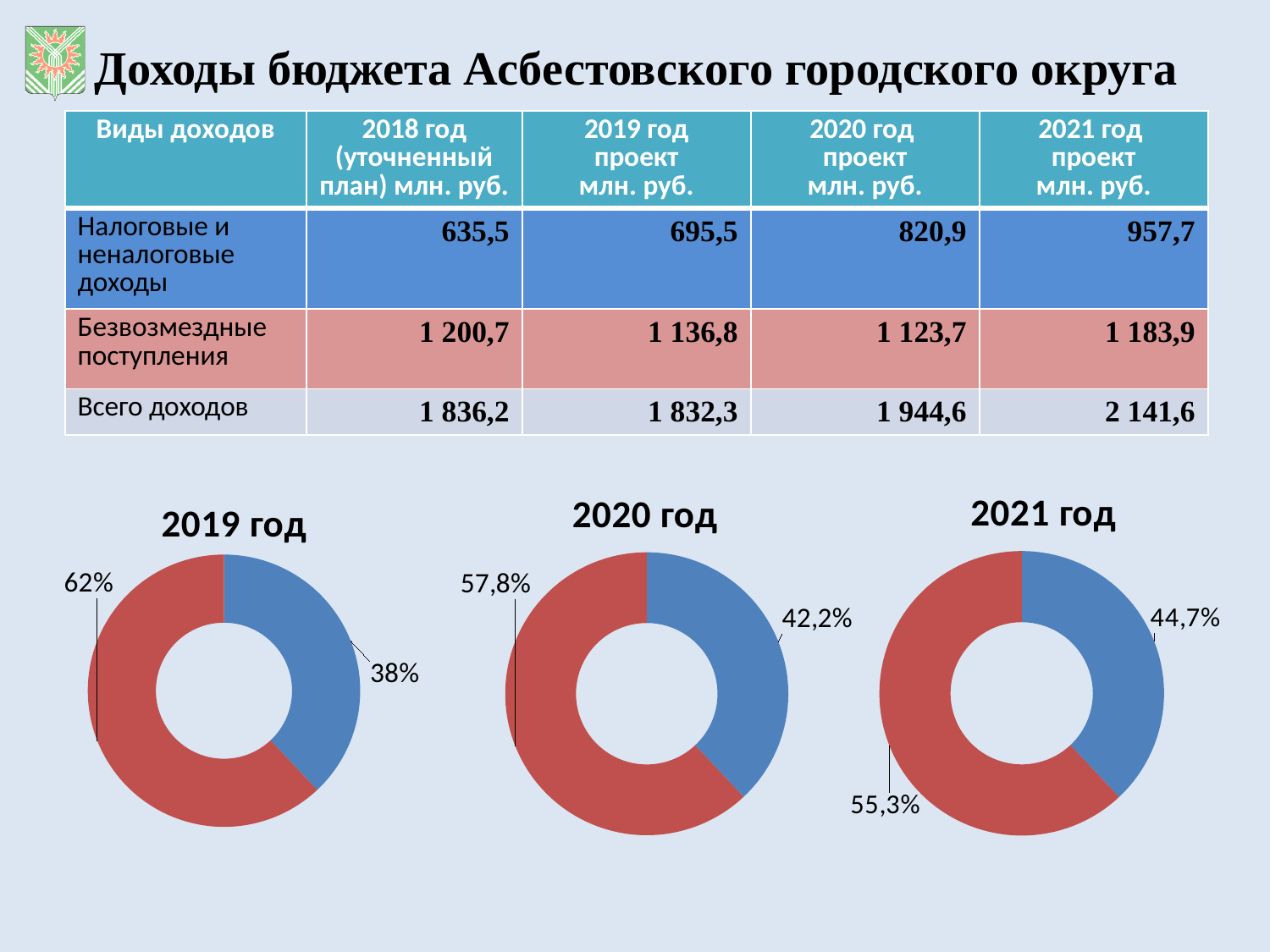
How many slices does the chart titled "2020 год" have? 2 In the chart titled "2021 год", what share does the blue slice have? 44,7% In the chart titled "2019 год", what share does the red slice have? 62% In the chart titled "2021 год", what share does the red slice have? 55,3% In the chart titled "2019 год", which slice is the largest? the red slice (62%) How many doughnut charts are shown on the slide? 3 Across the three charts, does the blue slice's share rise or fall from 2019 to 2021? rise What kind of chart is the one titled "2020 год"? doughnut (pie) chart In the chart titled "2021 год", which slice is larger, the blue one or the red one? the red one